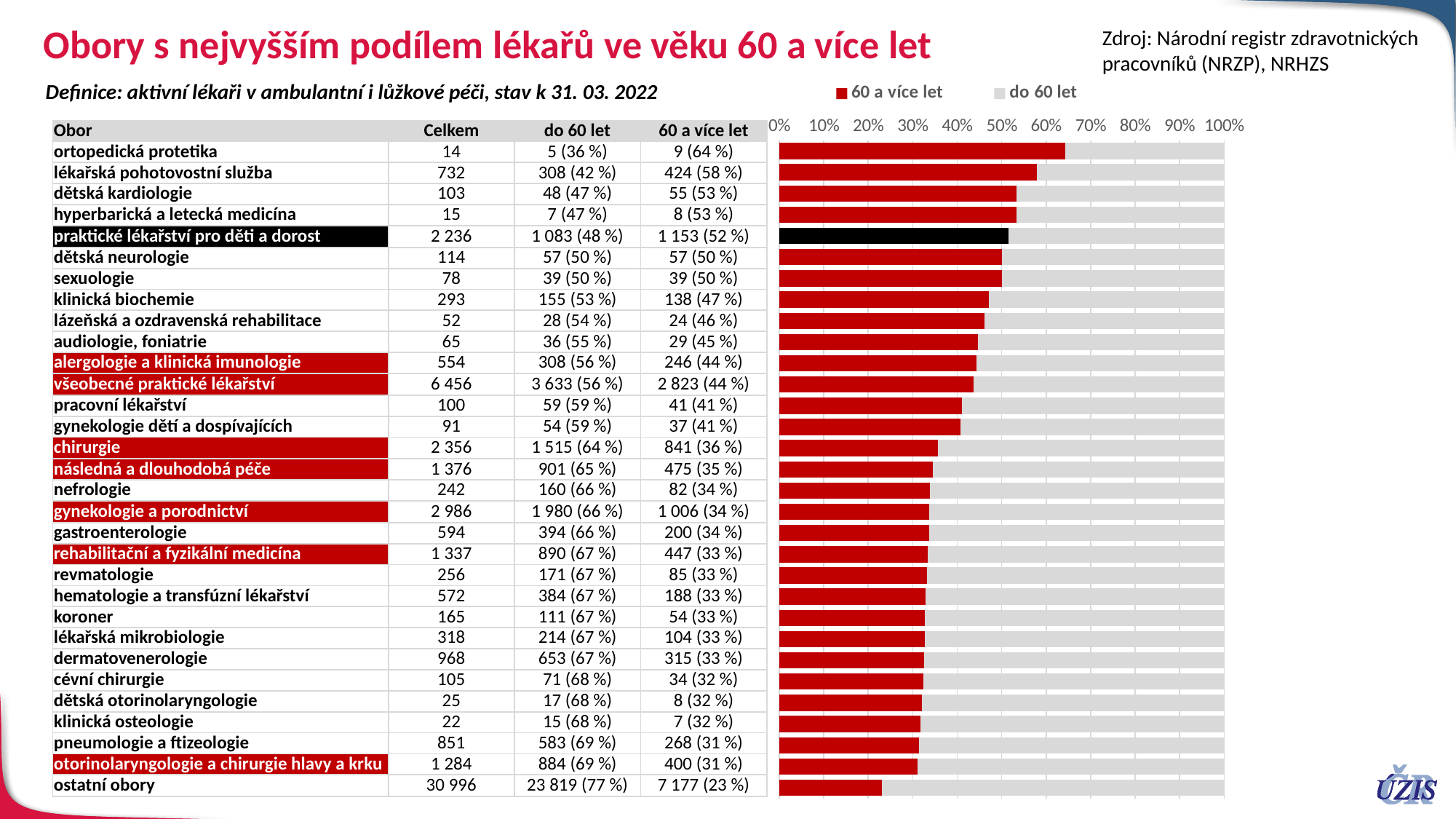
Which has a larger share of doctors aged 60 and over: dětská kardiologie or nefrologie? dětská kardiologie Which field has the highest share of doctors aged 60 and over? ortopedická protetika What kind of chart is shown on the right side of the slide? Stacked bar chart Which category has the lowest share of doctors aged 60 and over? ostatní obory How many series does the chart legend list? 2 How many categories (rows) are plotted in the chart? 31 Is the '60 a více let' share for ostatní obory greater or less than 30%? less What is the share of doctors aged 60 and over ('60 a více let') for ortopedická protetika? 64 % Which colour represents the series '60 a více let' in the chart? Red What is the share of doctors under 60 ('do 60 let') for chirurgie? 64 % What is the difference in percentage points between the '60 a více let' share for lékařská pohotovostní služba (58 %) and for ostatní obory (23 %)? 35 percentage points What are the two series named in the chart legend? 60 a více let; do 60 let